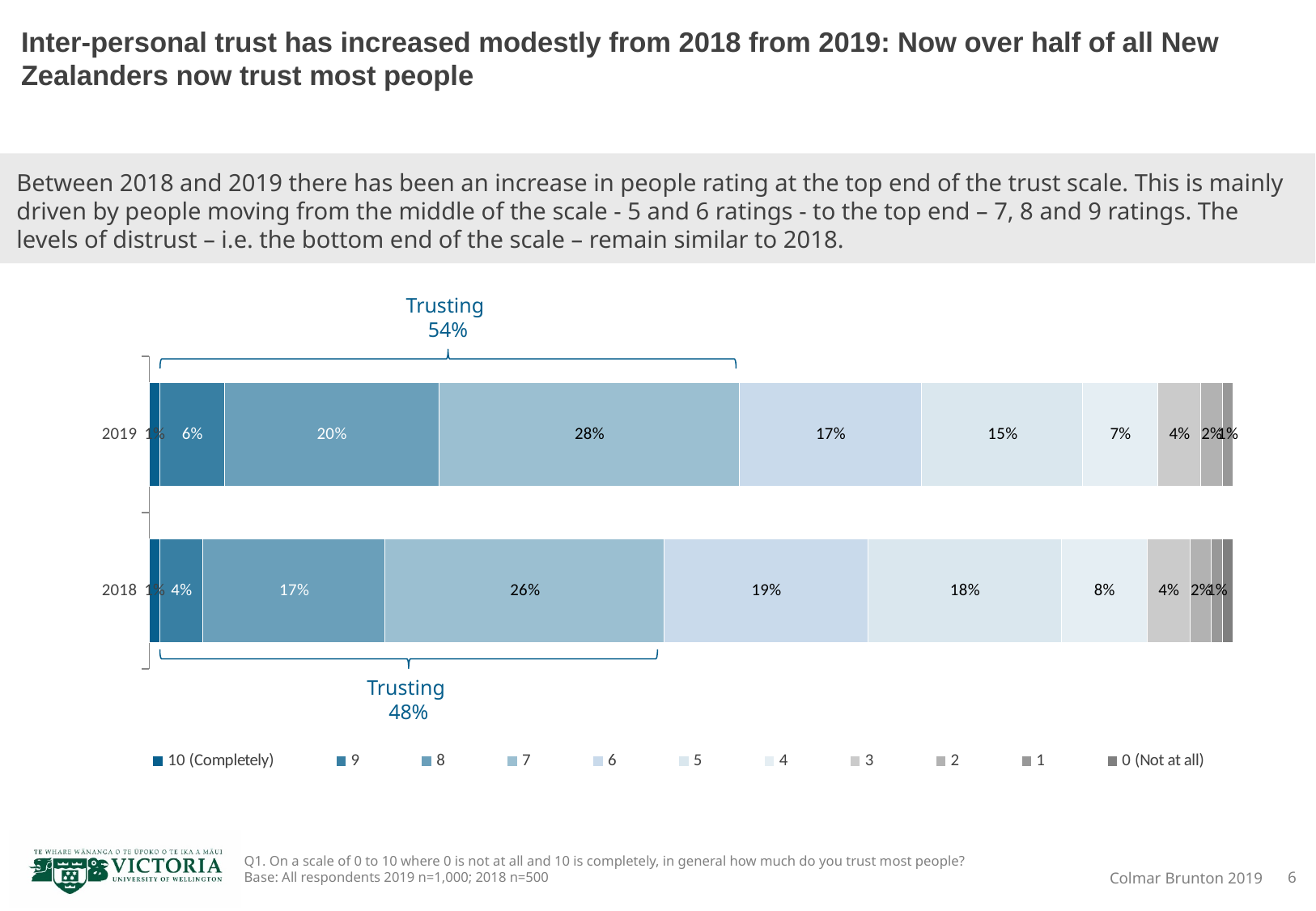
What percentage of respondents gave a rating of 8 in 2019? 20% What percentage of respondents gave a rating of 4 in 2019? 7% By how many percentage points did the share giving a rating of 8 change from 2018 to 2019? 3 percentage points What 'Trusting' percentage is shown above the 2019 bar? 54% How many series does the legend list? 11 What percentage of respondents gave a rating of 7 in 2018? 26% Which rating has the largest share in the 2019 bar? 7 What percentage of respondents gave a rating of 6 in 2019? 17% How many years (bars) are plotted in the chart? 2 What percentage of respondents gave a rating of 5 in 2018? 18% What kind of chart is shown on the slide? Stacked bar chart Which year had a larger share of respondents giving a rating of 9, 2018 or 2019? 2019